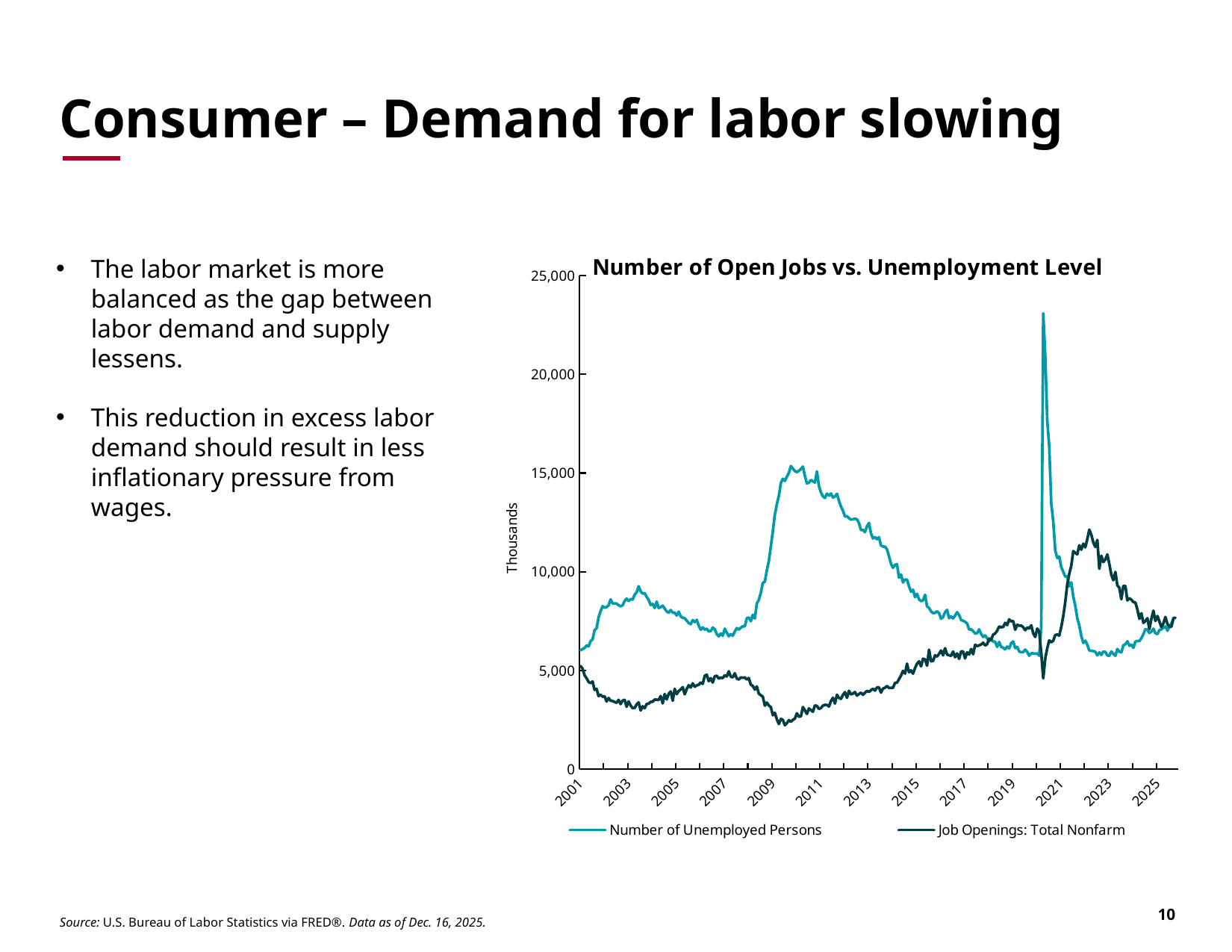
Around 2010, which series has the higher value: Number of Unemployed Persons or Job Openings: Total Nonfarm? Number of Unemployed Persons What is the label on the vertical axis of the chart? Thousands What is the title of the chart? Number of Open Jobs vs. Unemployment Level Is the value of Number of Unemployed Persons around 2010 greater or less than 10,000? greater Does the Number of Unemployed Persons series rise or fall between 2010 and 2019? fall How many series does the legend list? 2 Is the peak value of Number of Unemployed Persons around 2020 greater or less than 20,000? greater Around 2022, which series has the higher value: Number of Unemployed Persons or Job Openings: Total Nonfarm? Job Openings: Total Nonfarm Is the value of Job Openings: Total Nonfarm around 2009 greater or less than 5,000? less How many year labels are shown on the x axis? 13 What kind of chart is shown on the slide? line chart Which series reaches the highest value anywhere on the chart? Number of Unemployed Persons